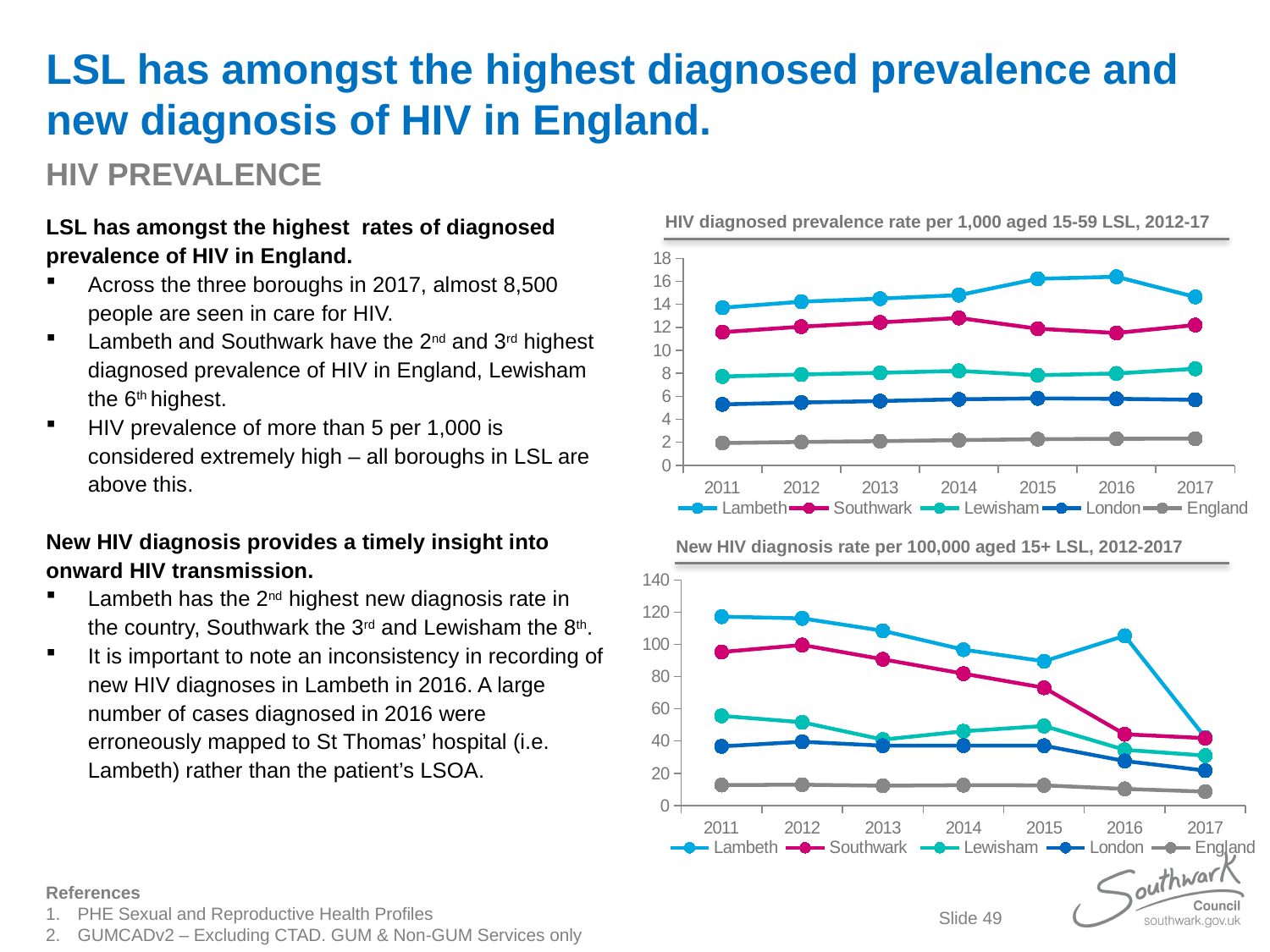
In the 'New HIV diagnosis rate per 100,000 aged 15+' chart, which series has the highest value in 2016? Lambeth In the 'HIV diagnosed prevalence rate per 1,000' chart, which series has the highest value in 2016? Lambeth How many series does the legend of the 'HIV diagnosed prevalence rate per 1,000' chart list? 5 How many years are shown on the x axis of the 'HIV diagnosed prevalence rate per 1,000' chart? 7 In the 'HIV diagnosed prevalence rate per 1,000' chart, which series has the lowest values across all years? England In the 'HIV diagnosed prevalence rate per 1,000' chart, is the value for England in 2011 greater or less than 4? less In the 'New HIV diagnosis rate per 100,000 aged 15+' chart, which is larger in 2012: Southwark or Lewisham? Southwark In the 'New HIV diagnosis rate per 100,000 aged 15+' chart, do the values for Lambeth rise or fall from 2011 to 2015? Fall In the 'New HIV diagnosis rate per 100,000 aged 15+' chart, is the value for England in 2011 greater or less than 20? less What kind of chart is the 'HIV diagnosed prevalence rate per 1,000 aged 15-59 LSL, 2012-17' chart? Line chart In the 'New HIV diagnosis rate per 100,000 aged 15+' chart, is the value for Lambeth in 2017 greater or less than 60? less